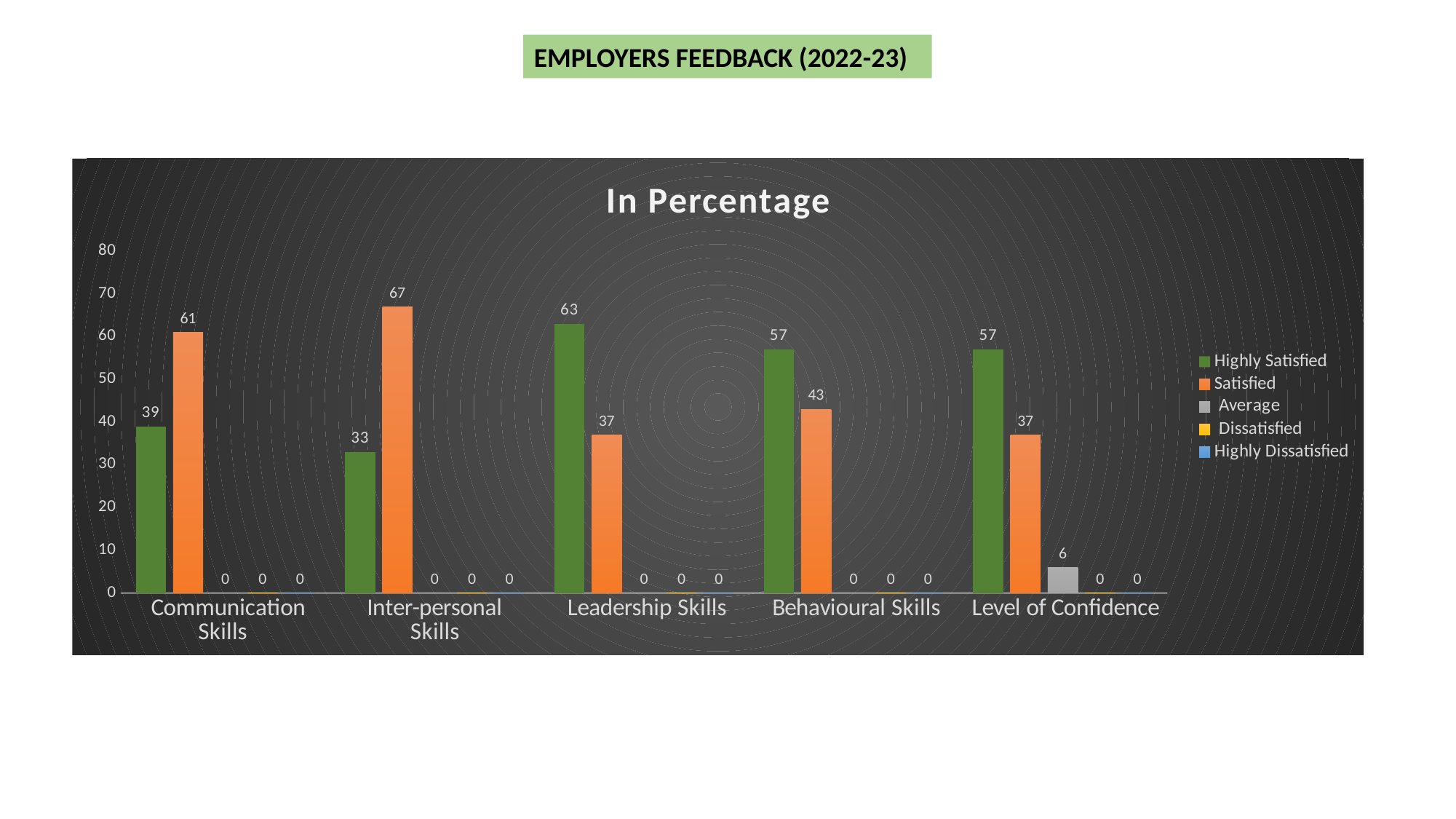
What is the Satisfied value for Inter-personal Skills? 67 Is the Highly Satisfied value for Leadership Skills greater or less than 60? greater How many categories are shown on the x axis? 5 What is the Highly Satisfied value for Communication Skills? 39 How many series does the legend list? 5 What kind of chart is shown on the slide? bar chart What is the title of the chart? In Percentage Which category has the highest Satisfied value? Inter-personal Skills For Behavioural Skills, which is larger: Highly Satisfied or Satisfied? Highly Satisfied Which category has the lowest Highly Satisfied value? Inter-personal Skills What is the difference between the Satisfied and Highly Satisfied values for Leadership Skills? 26 What is the Average value for Level of Confidence? 6